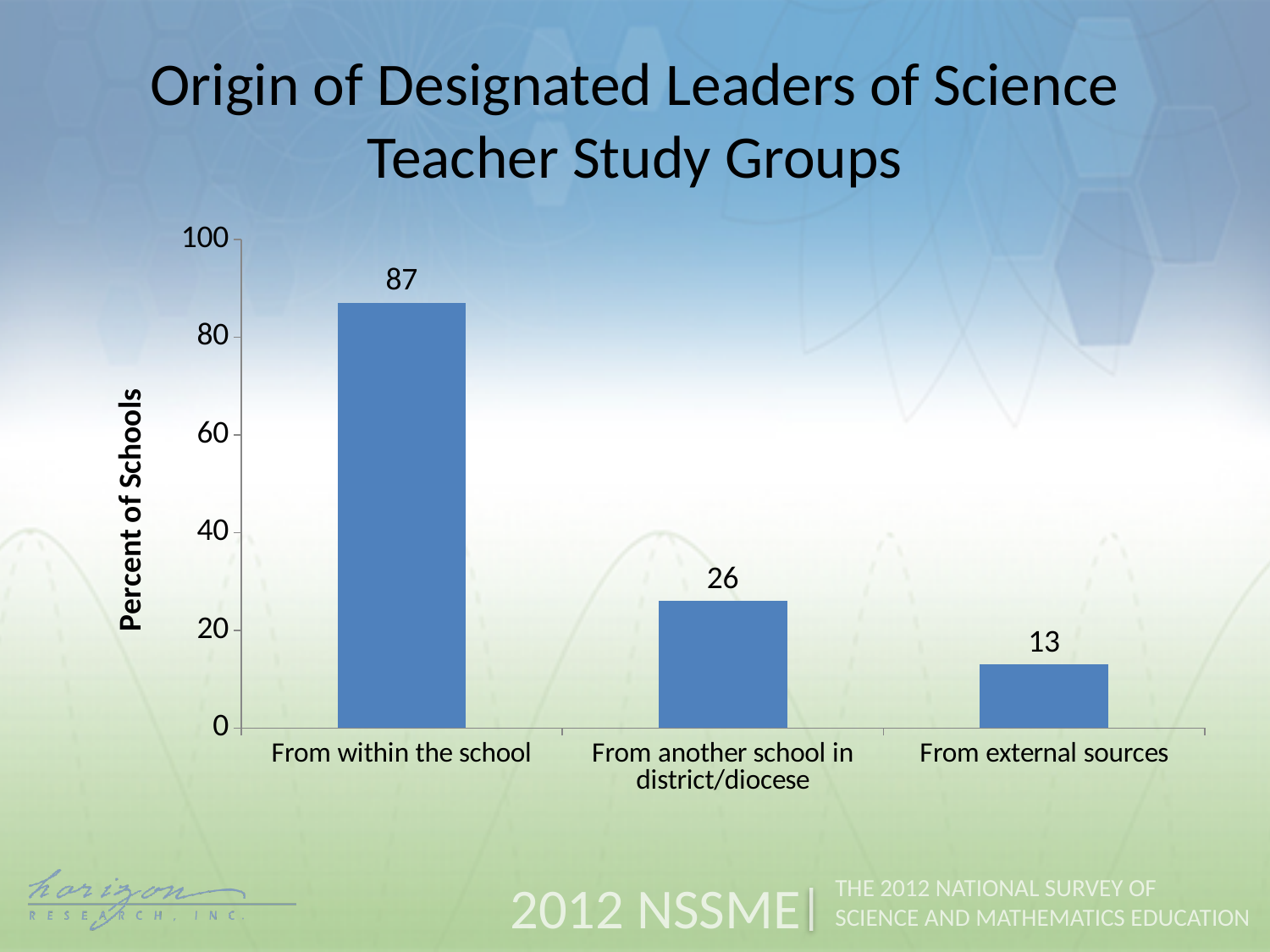
What is the difference between the values for "From another school in district/diocese" and "From external sources"? 13 What kind of chart is shown on the slide? Bar chart What is the difference between the values for "From within the school" and "From another school in district/diocese"? 61 How many categories are shown on the x axis? 3 What is the value for "From external sources"? 13 What is the value for "From within the school"? 87 Which category has the highest value? From within the school Which is larger, the value for "From another school in district/diocese" or "From external sources"? From another school in district/diocese What is the label of the vertical axis? Percent of Schools What is the value for "From another school in district/diocese"? 26 Which category has the lowest value? From external sources Is the value for "From within the school" greater or less than 80? greater